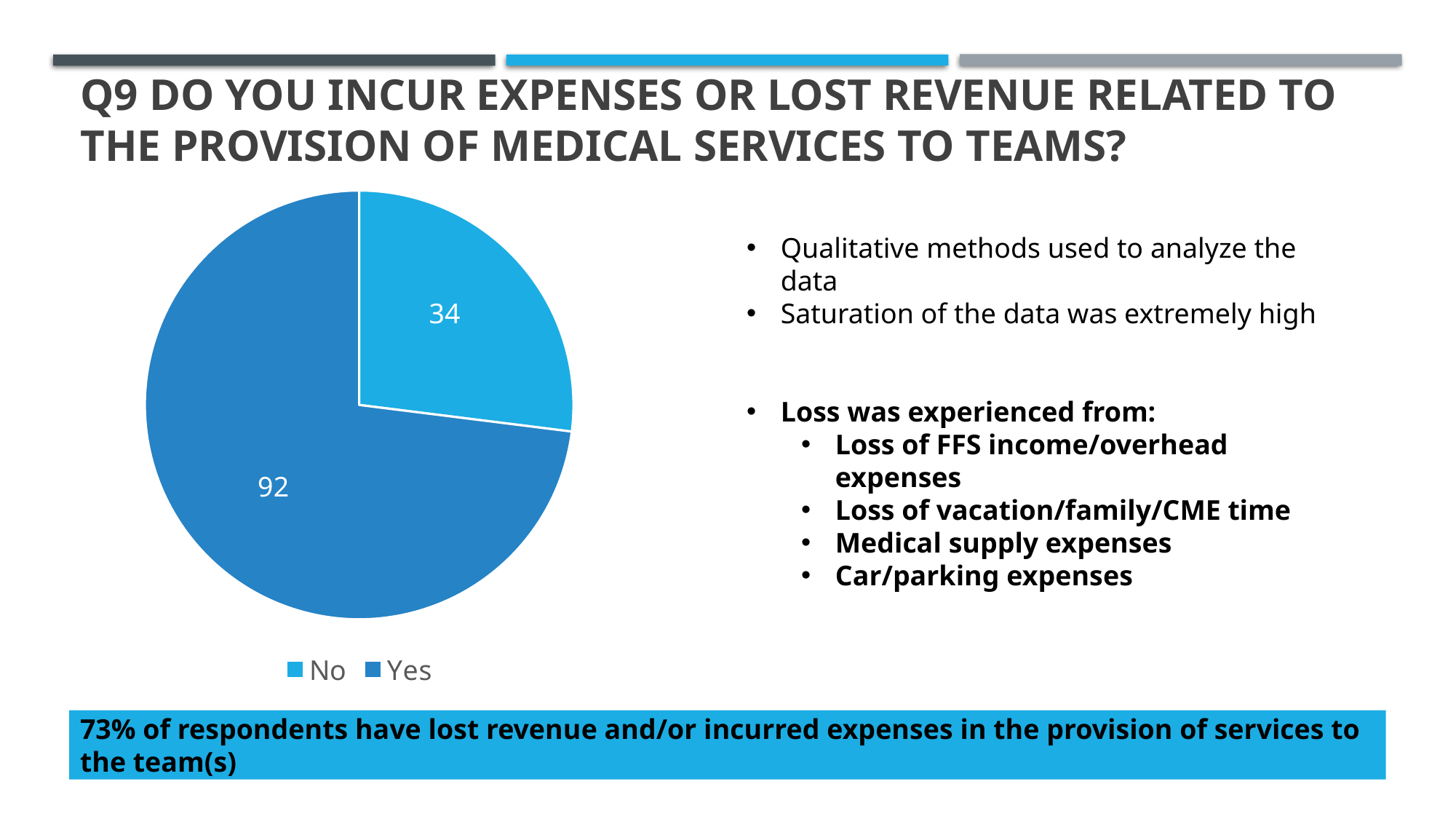
What share of the pie does the Yes slice represent, to the nearest percent? 73% What kind of chart is shown on the slide? pie chart How many categories does the pie chart show? 2 What is the value for No in the pie chart? 34 Which is larger in the pie chart, Yes or No? Yes What is the difference between the Yes and No values in the pie chart? 58 Which legend entry is shown in the lighter blue colour? No Which category has the smallest slice in the pie chart? No What is the total of the values shown in the pie chart? 126 What share of the pie does the No slice represent, to the nearest percent? 27% What is the value for Yes in the pie chart? 92 Which category has the largest slice in the pie chart? Yes